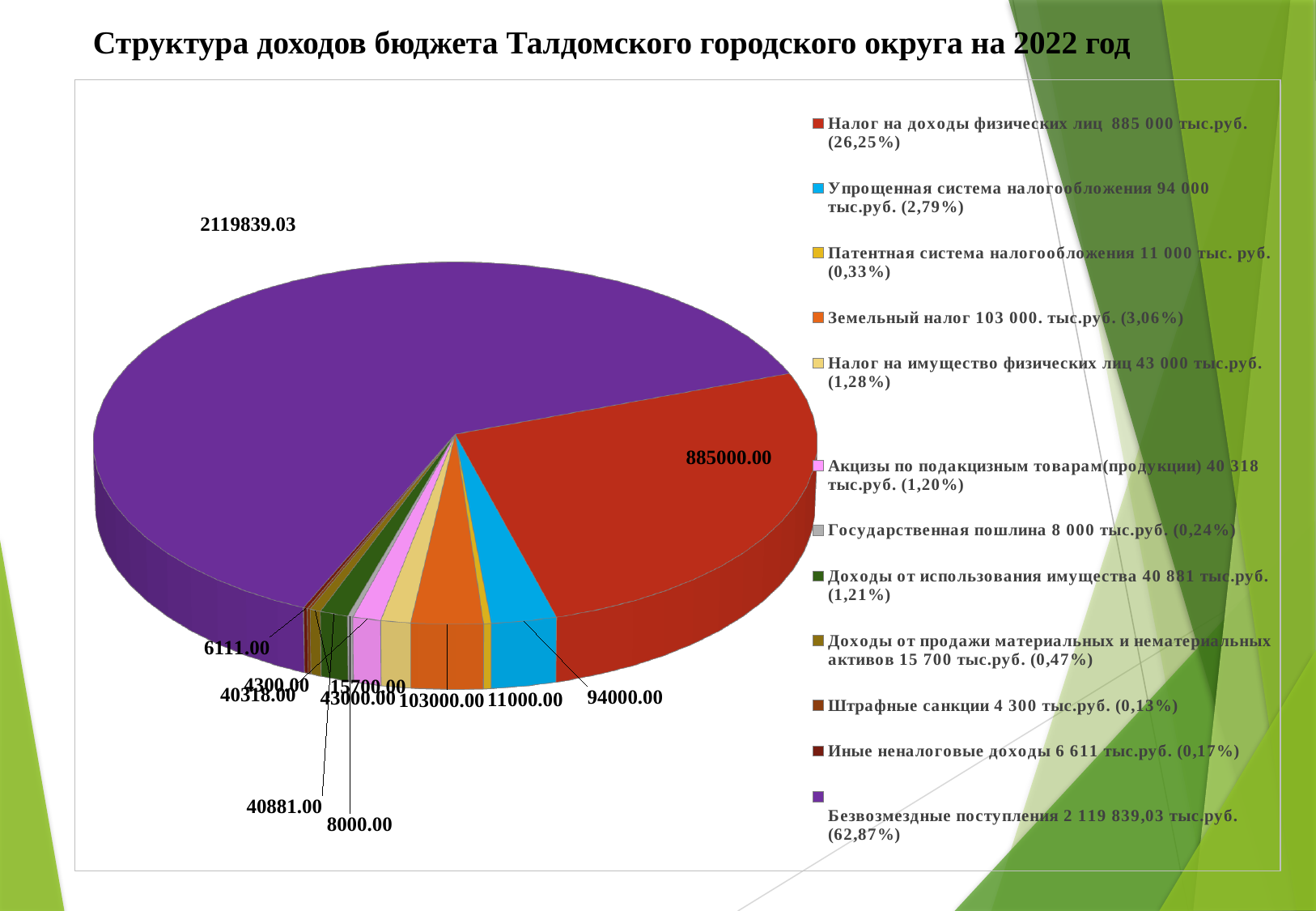
Which category has the largest slice of the pie? Безвозмездные поступления What is the difference between the data label values for 'Земельный налог' and 'Упрощенная система налогообложения'? 9000.00 What share of the pie does 'Безвозмездные поступления' represent, according to the legend? 62,87% How many entries does the legend of the pie chart list? 12 What type of chart is shown on the slide? pie chart What is the data label value for the slice 'Упрощенная система налогообложения'? 94000.00 Which is larger: the slice for 'Земельный налог' or the slice for 'Упрощенная система налогообложения'? Земельный налог What share of the pie does 'Налог на доходы физических лиц' represent, according to the legend? 26,25% Which category has the smallest slice of the pie? Штрафные санкции What is the data label value for the slice 'Налог на доходы физических лиц'? 885000.00 What is the data label value for the slice 'Безвозмездные поступления'? 2119839.03 What is the data label value for the slice 'Земельный налог'? 103000.00